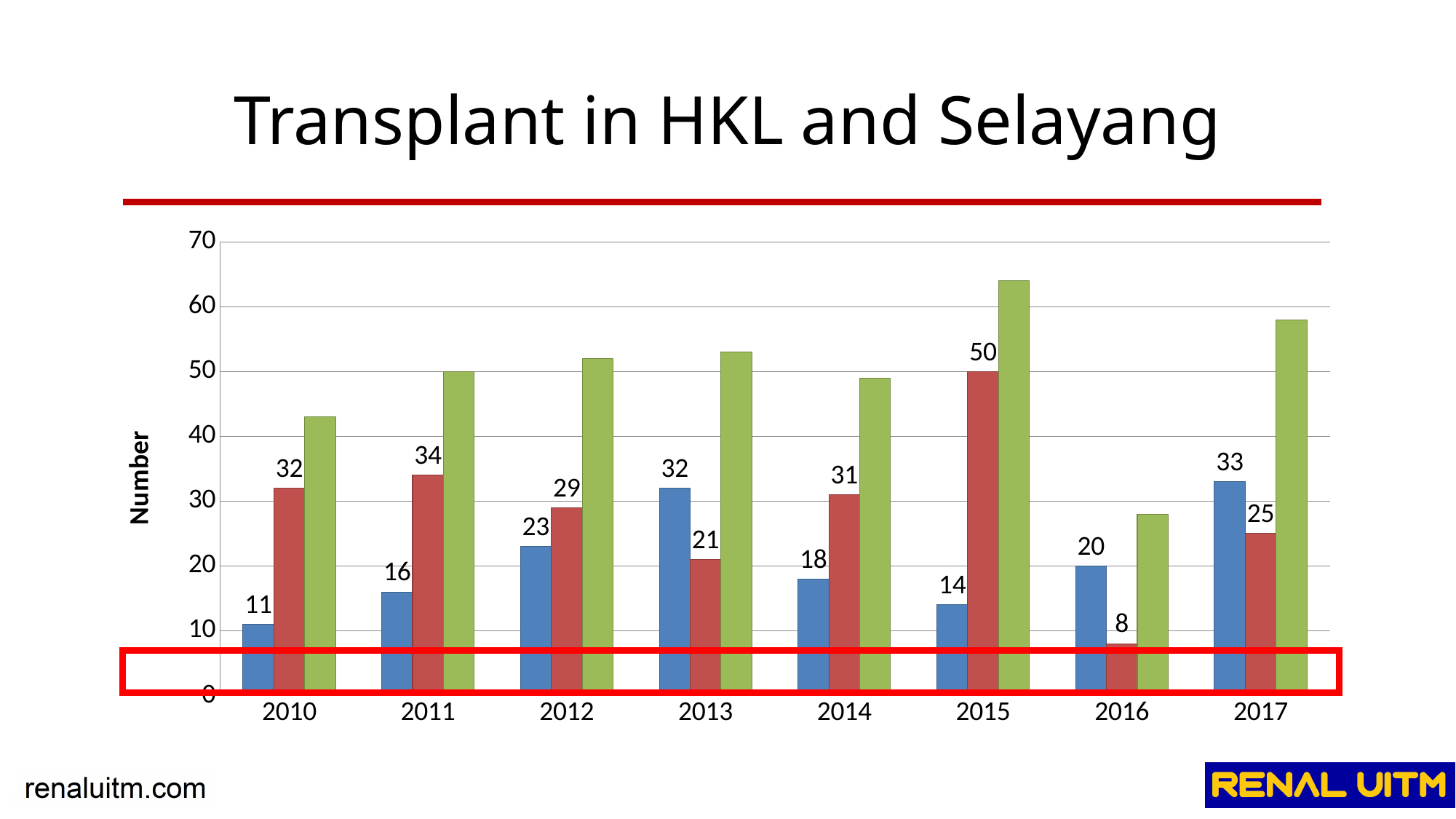
What is the difference between the red bar and the blue bar in 2015? 36 In 2012, which is larger, the blue bar or the red bar? the red bar Is the value of the green bar for 2016 greater or less than 30? less What kind of chart is shown on the slide? bar chart How many years are shown on the x axis? 8 Is the value of the green bar for 2015 greater or less than 60? greater In which year is the red bar lowest? 2016 What is the value of the red bar for 2016? 8 What is the value of the blue bar for 2013? 32 What is the value of the red bar for 2015? 50 In which year is the blue bar highest? 2017 What is the title of the y axis? Number